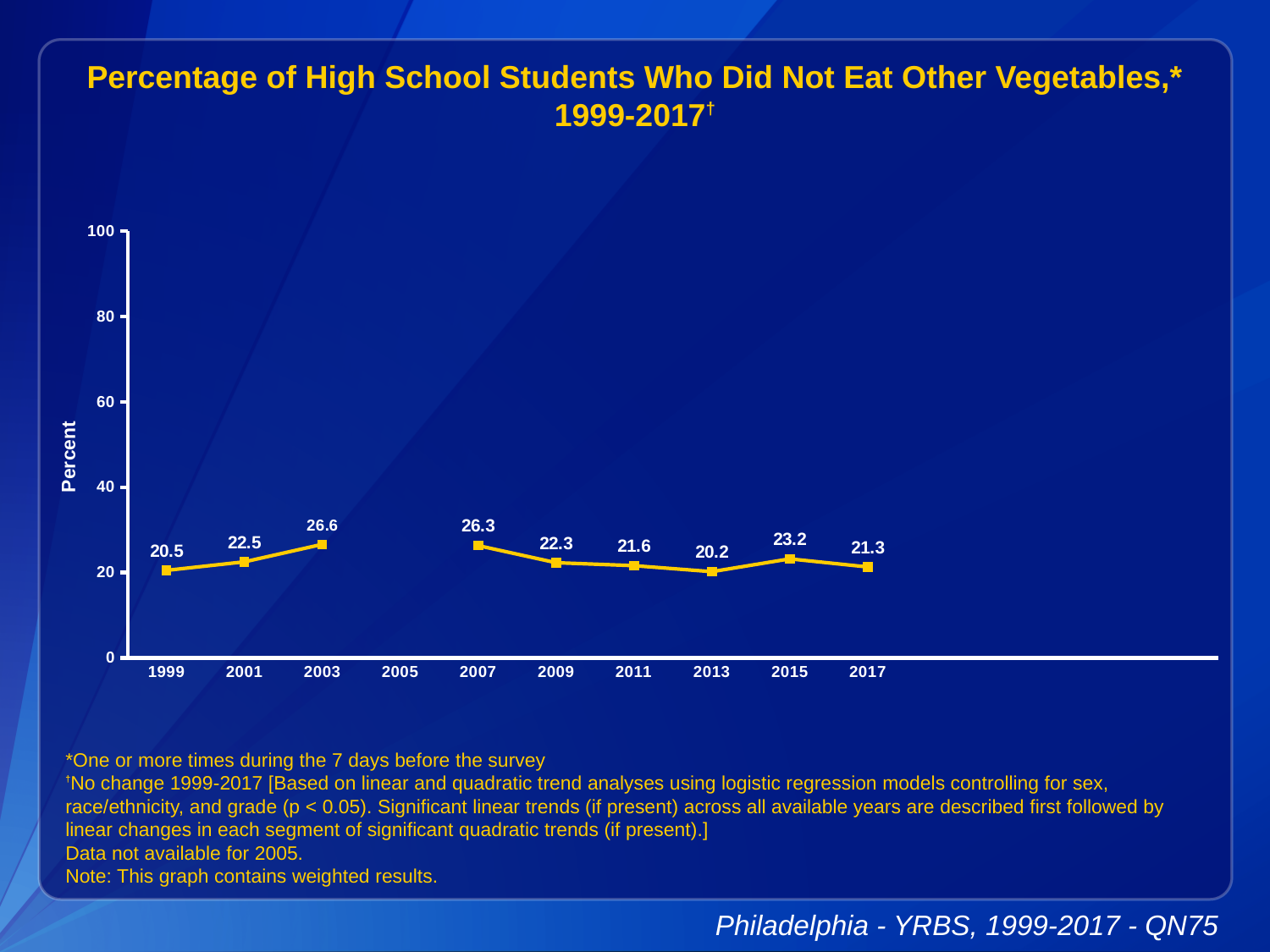
What is the difference between the values for 2003 and 1999? 6.1 What is the value for 2013? 20.2 Which year has the highest value? 2003 How many data points are plotted on the chart? 9 Which is larger, the value for 2015 or the value for 2011? 2015 Which year has no data point plotted? 2005 Is the value for 2007 greater or less than 40? less Which year has the lowest value? 2013 What is the label on the y axis? Percent What kind of chart is shown? line chart What is the value for 2017? 21.3 What is the value for 1999? 20.5